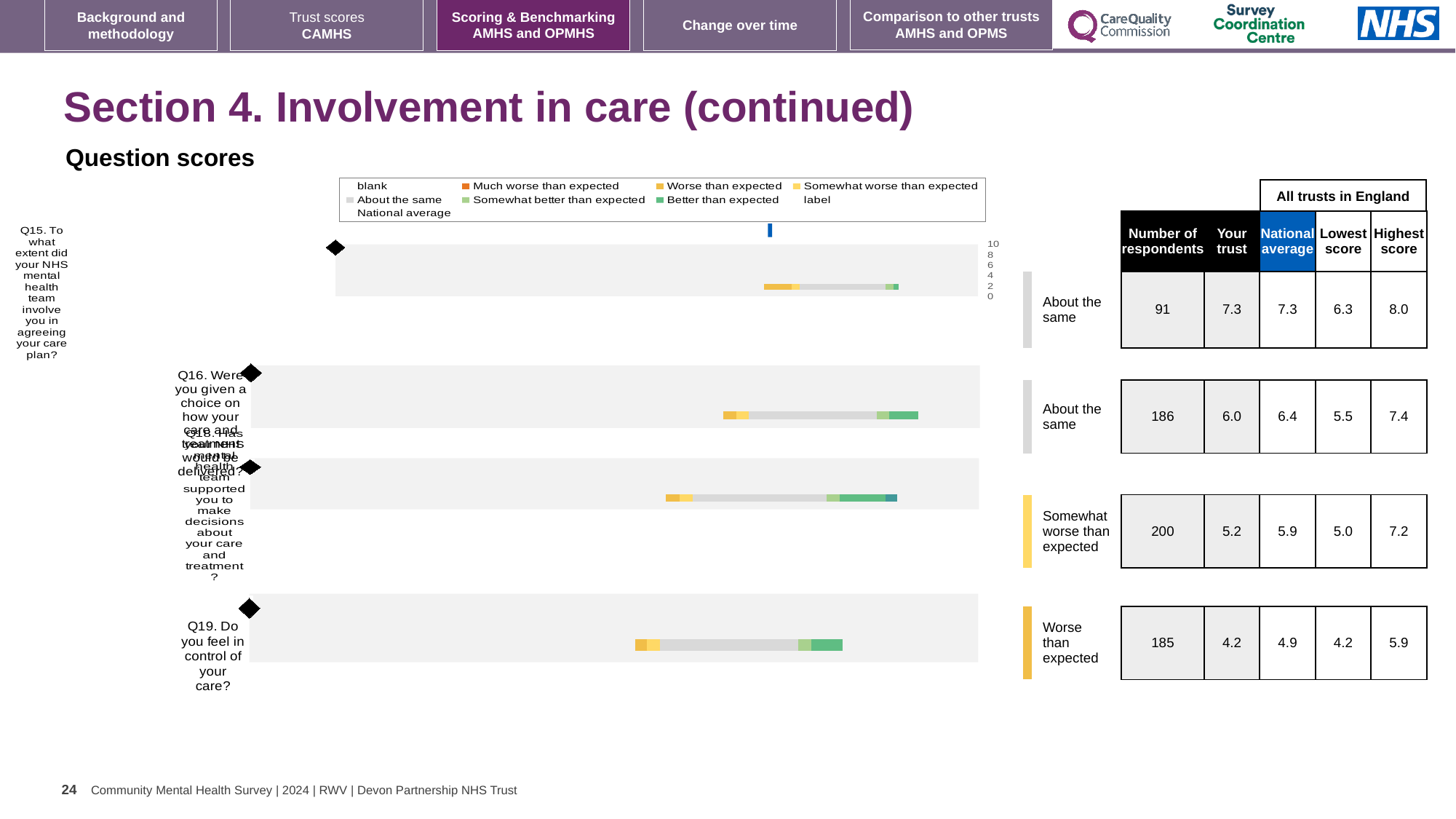
What benchmark category is shown for Q19? Worse than expected What kind of chart is used to show the question scores on this slide? bar chart How many questions (Q15, Q16, Q18, Q19) are plotted in the question scores chart? 4 What is the highest score across all trusts in England shown for Q15? 8.0 For Q16, what is the difference between the national average and the 'Your trust' score? 0.4 Which question has the highest 'Your trust' score on this slide? Q15 What benchmark category is shown for Q18? Somewhat worse than expected How many respondents are shown for Q18 (Has your NHS mental health team supported you to make decisions about your care and treatment?)? 200 Which question has the lowest 'Your trust' score on this slide? Q19 What is the 'Your trust' score shown for Q19 (Do you feel in control of your care?)? 4.2 For Q18, which is larger: the 'Your trust' score or the national average? National average